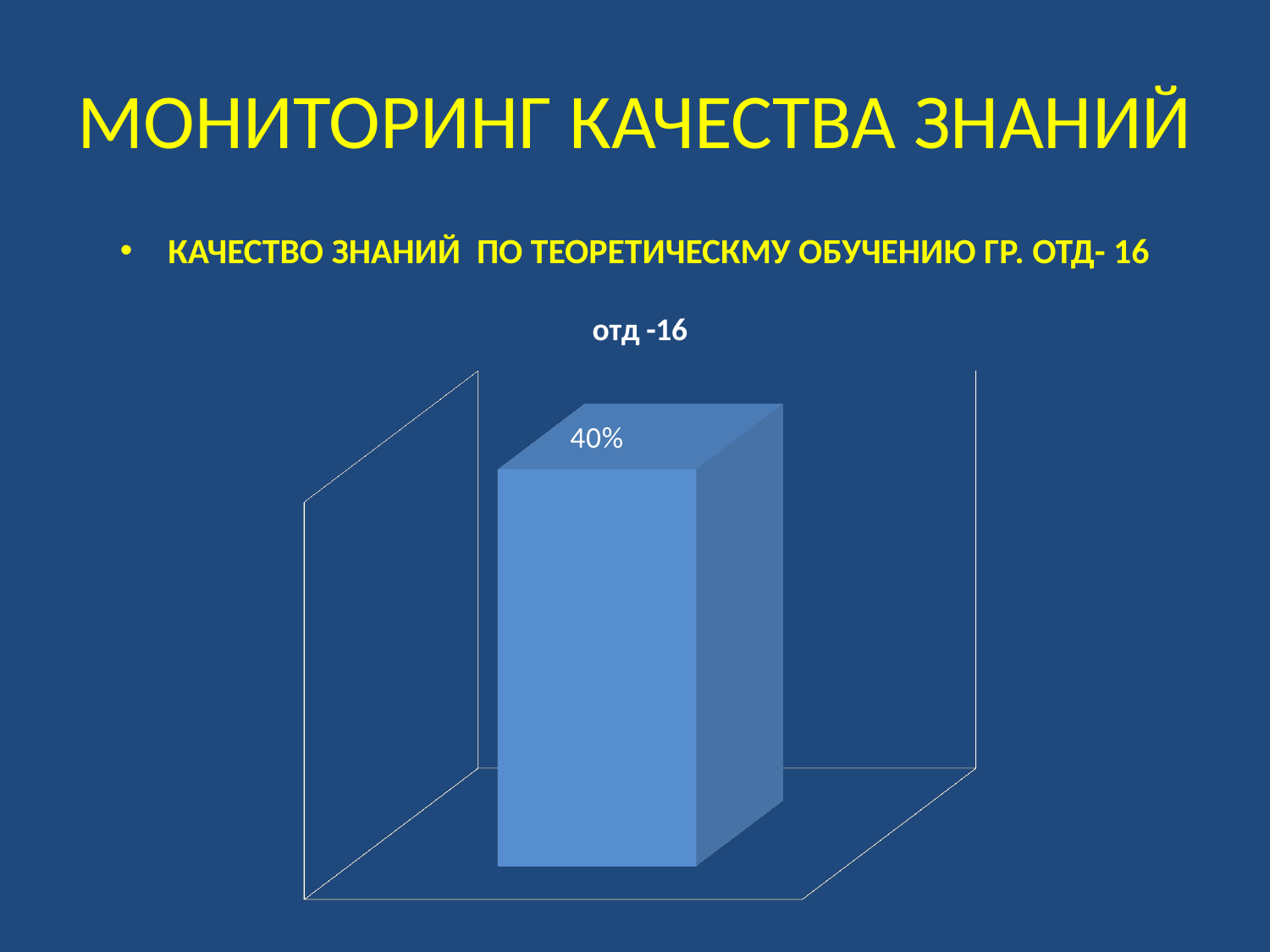
How many bars are plotted in the chart? 1 Is the value shown on the bar greater or less than 50%? less What kind of chart is shown on the slide? bar chart What is the title of the chart? отд -16 What value is shown on the bar in the chart? 40%